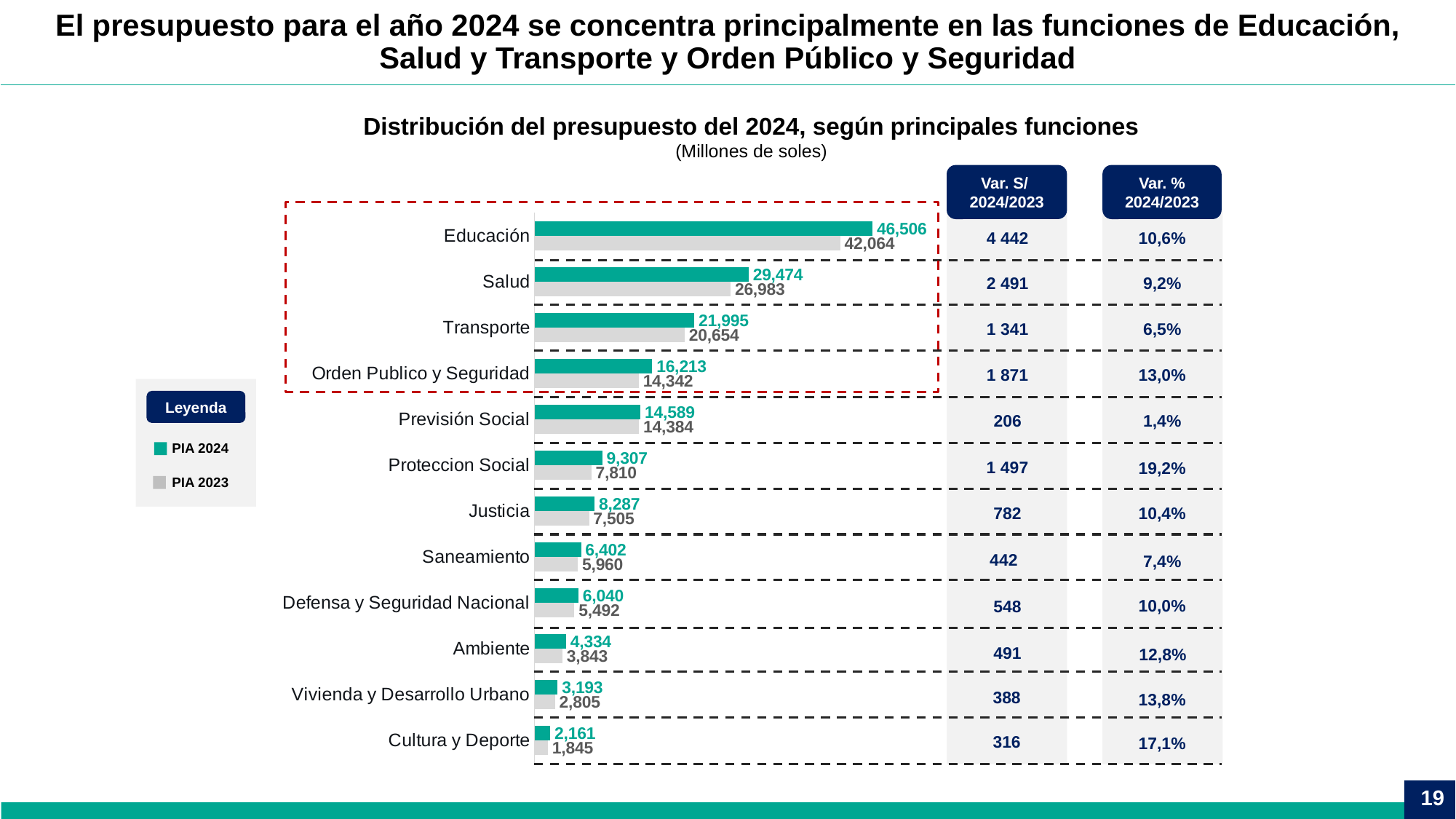
How many functions (categories) are shown in the chart? 12 What is the PIA 2023 value for Salud? 26,983 What kind of chart is shown on the slide? Bar chart What is the PIA 2024 value for Orden Publico y Seguridad? 16,213 What is the PIA 2023 value for Cultura y Deporte? 1,845 What is the PIA 2024 value for Educación? 46,506 What is the difference between the PIA 2024 and PIA 2023 values for Educación? 4,442 What is the difference between the PIA 2024 values for Educación and Salud? 17,032 Which function has the highest PIA 2024 value? Educación Which is larger: the PIA 2024 value for Justicia or the PIA 2024 value for Saneamiento? Justicia How many series does the legend list? 2 Which function has the lowest PIA 2023 value? Cultura y Deporte